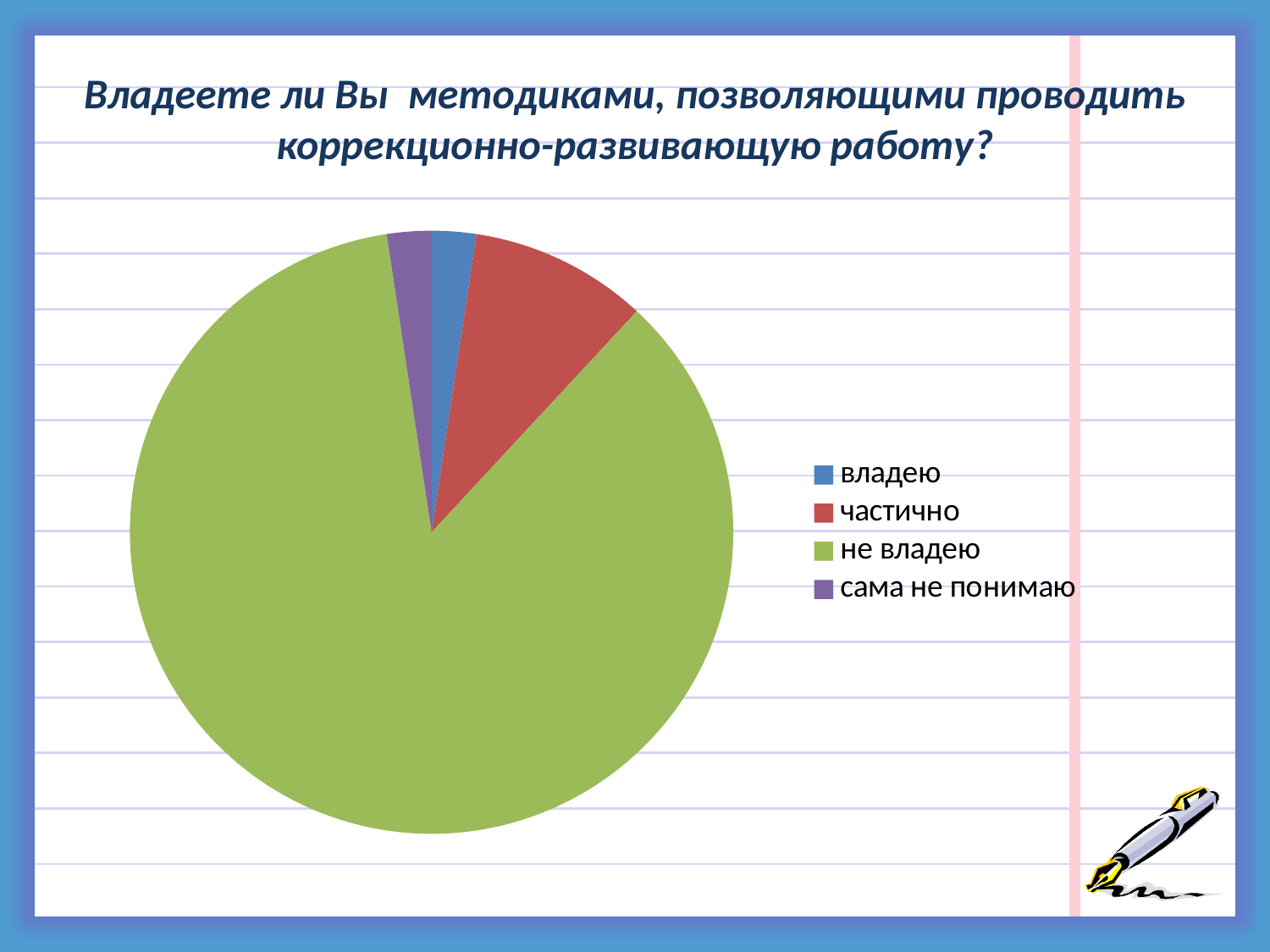
What is the title of the chart? Владеете ли Вы методиками, позволяющими проводить коррекционно-развивающую работу? Which category has the largest slice of the pie? не владею How many categories does the pie chart show? 4 How many entries does the legend list? 4 Which slice is larger, "владею" or "частично"? частично Which slice is larger, "не владею" or "сама не понимаю"? не владею What colour is the slice for "не владею"? green Which slice is larger, "частично" or "не владею"? не владею What kind of chart is shown on the slide? pie chart